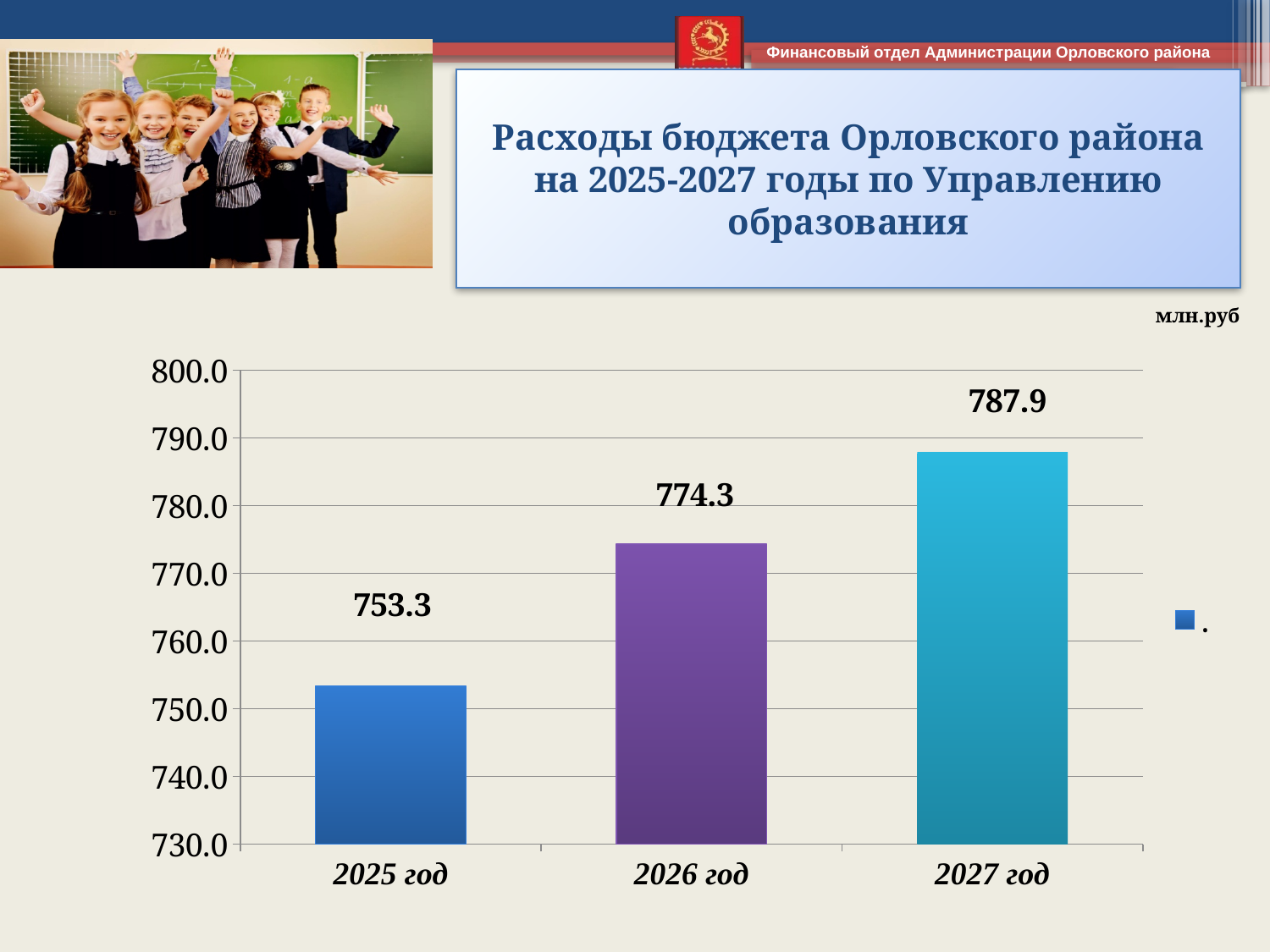
Is the value for 2026 год greater or less than 770.0? greater What kind of chart is shown on the slide? bar chart What is the difference between the values for 2026 год and 2025 год? 21.0 What is the value for 2026 год? 774.3 Which year has the lowest value? 2025 год Which year has the highest value? 2027 год Do the values rise or fall from 2025 год to 2027 год? rise What is the value for 2025 год? 753.3 How many years are shown on the x axis? 3 What is the value for 2027 год? 787.9 Which is larger, the value for 2026 год or the value for 2027 год? 2027 год What is the difference between the values for 2027 год and 2025 год? 34.6